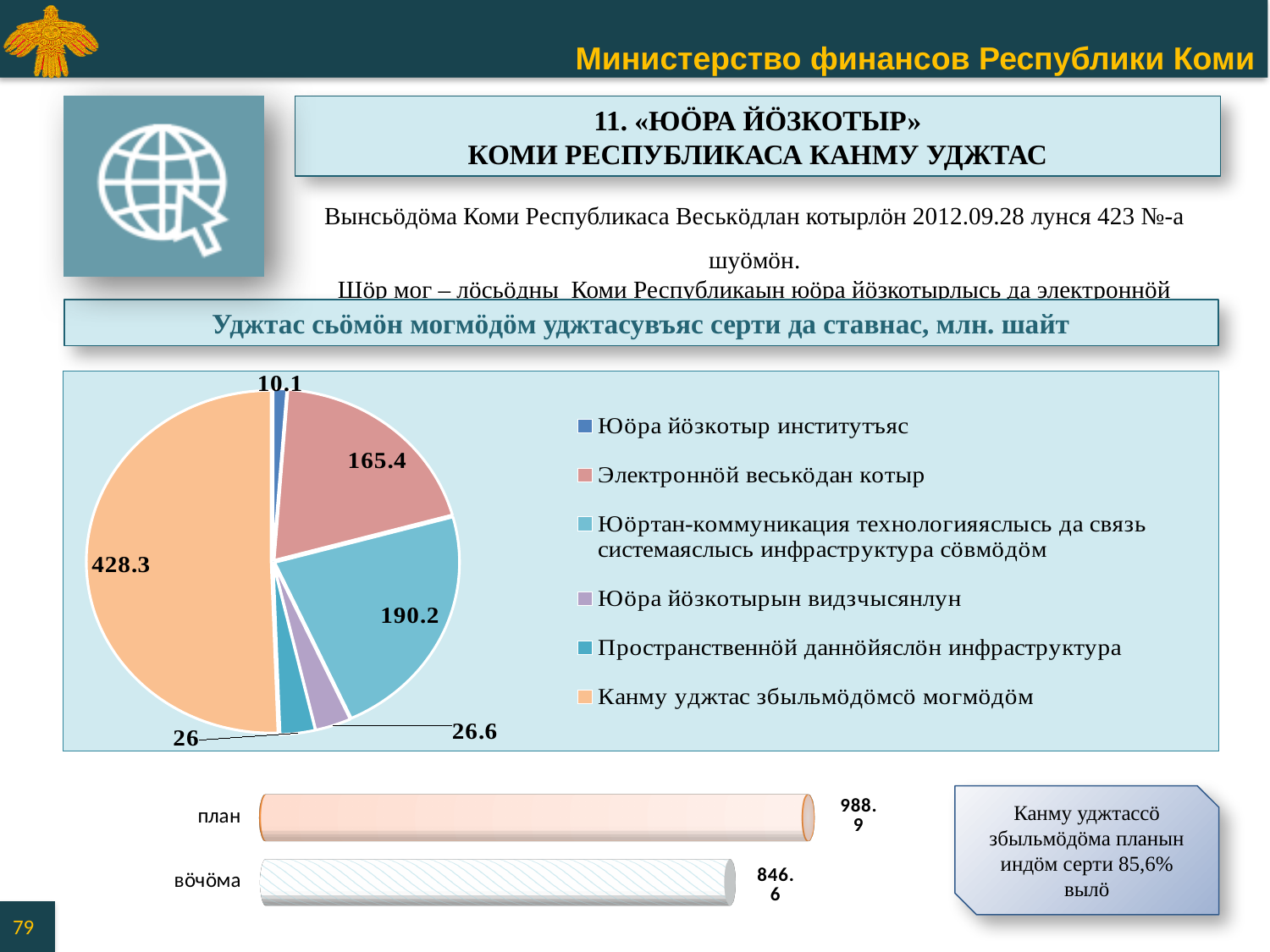
In the pie chart, which category has the largest slice? Канму уджтас збыльмöдöмсö могмöдöм In the bar chart at the bottom of the slide, what is the difference between план and вöчöма? 142.3 In the bar chart at the bottom of the slide, what is the value for план? 988.9 How many slices does the pie chart have? 6 What type of chart is the upper chart on the slide? pie chart In the pie chart, what is the value for Юöра йöзкотыр институтъяс? 10.1 In the pie chart, which category has the smallest slice? Юöра йöзкотыр институтъяс In the pie chart, what is the value for Канму уджтас збыльмöдöмсö могмöдöм? 428.3 In the bar chart at the bottom of the slide, what is the value for вöчöма? 846.6 In the pie chart, which is larger: Электроннöй веськöдан котыр or Юöртан-коммуникация технологияслысь да связь системаяслысь инфраструктура сöвмöдöм? Юöртан-коммуникация технологияслысь да связь системаяслысь инфраструктура сöвмöдöм In the pie chart, what is the value for Электроннöй веськöдан котыр? 165.4 In the pie chart, what is the difference between the values for Юöртан-коммуникация технологияслысь да связь системаяслысь инфраструктура сöвмöдöм and Электроннöй веськöдан котыр? 24.8